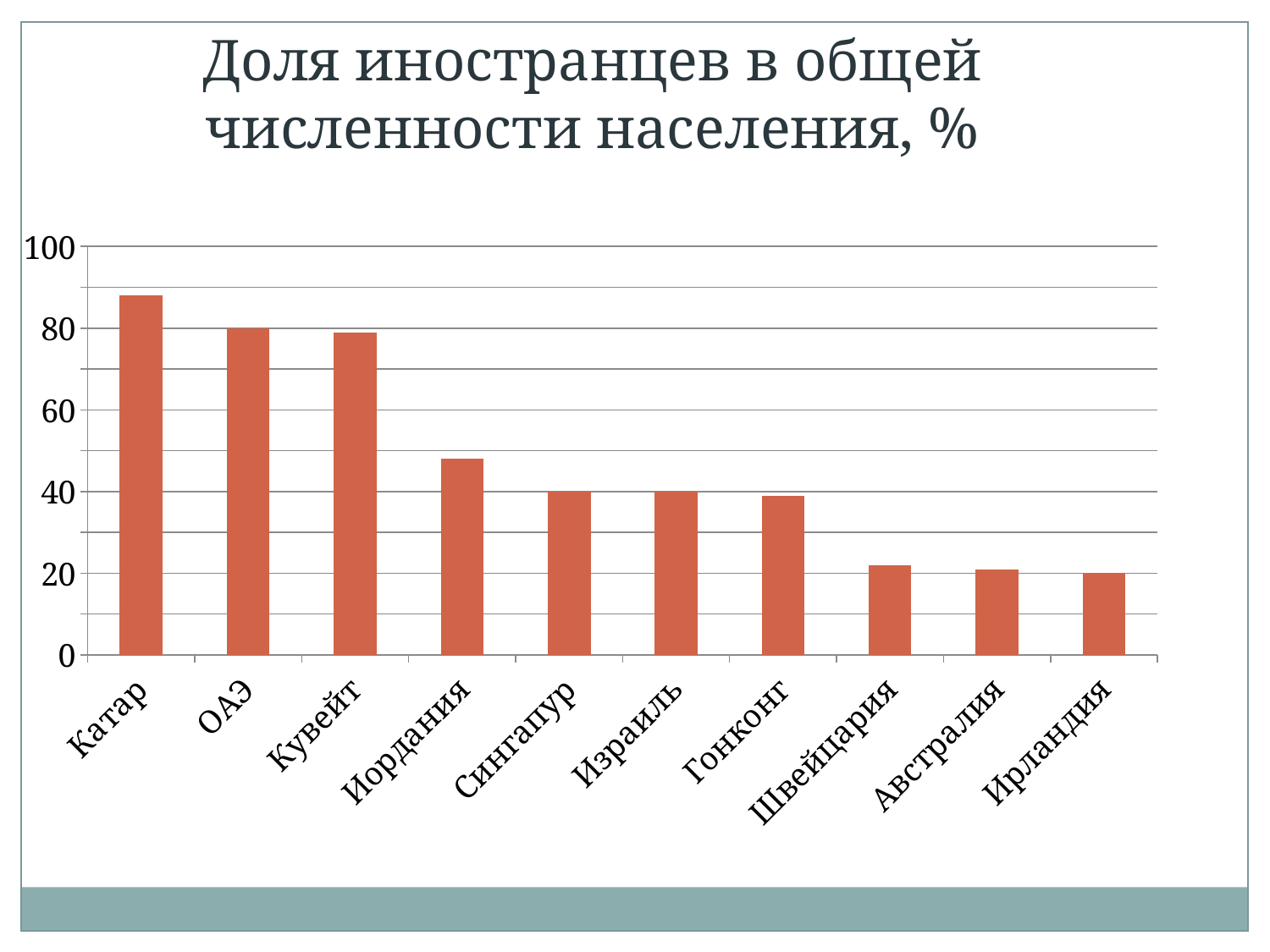
Is the value for Сингапур greater or less than 60? less Is the value for Кувейт greater or less than 60? greater Is the value for Катар greater or less than 80? greater Which country has the highest share of foreigners in the total population? Катар Do the values generally rise or fall from left to right along the x axis? fall Which is larger, the value for Швейцария or the value for Иордания? Иордания How many countries are shown on the chart? 10 Which is larger, the value for Катар or the value for Иордания? Катар What kind of chart is shown on the slide? bar chart